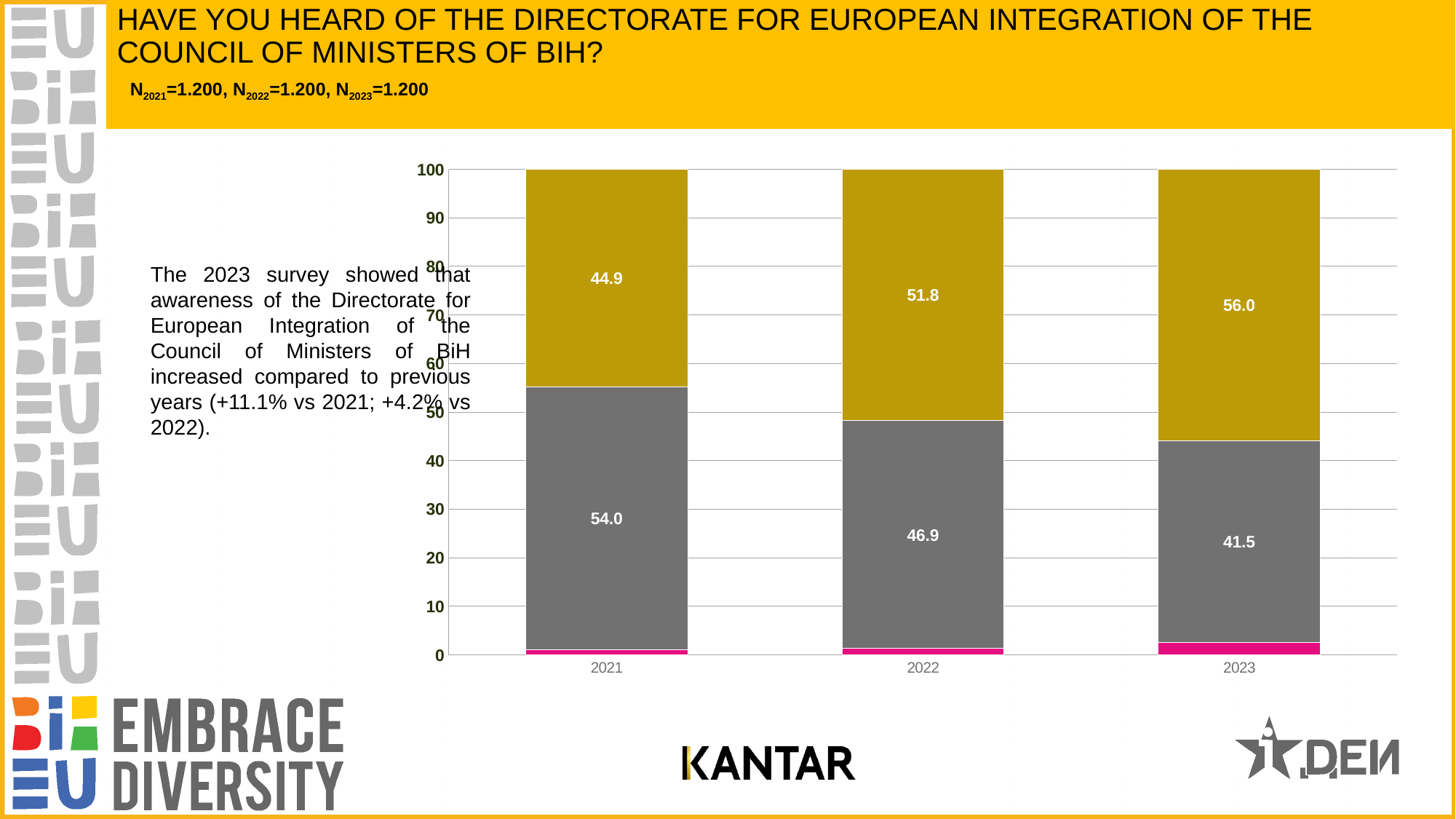
Is the value of the magenta (bottom) segment for 2023 greater or less than 10? less In which year is the grey (middle) segment the smallest? 2023 What kind of chart is shown on the slide? stacked bar chart What is the value of the grey (middle) segment for 2021? 54.0 In which year is the gold (top) segment the largest? 2023 In 2021, which segment is larger, the gold one or the grey one? grey (54.0) What is the value of the grey (middle) segment for 2023? 41.5 What is the difference between the gold segment values for 2023 and 2021? 11.1 What is the value of the gold (top) segment for 2022? 51.8 How many years (categories) are shown on the x axis of the chart? 3 What is the value of the gold (top) segment for 2023? 56.0 Do the gold (top) segment values rise or fall from 2021 to 2023? rise